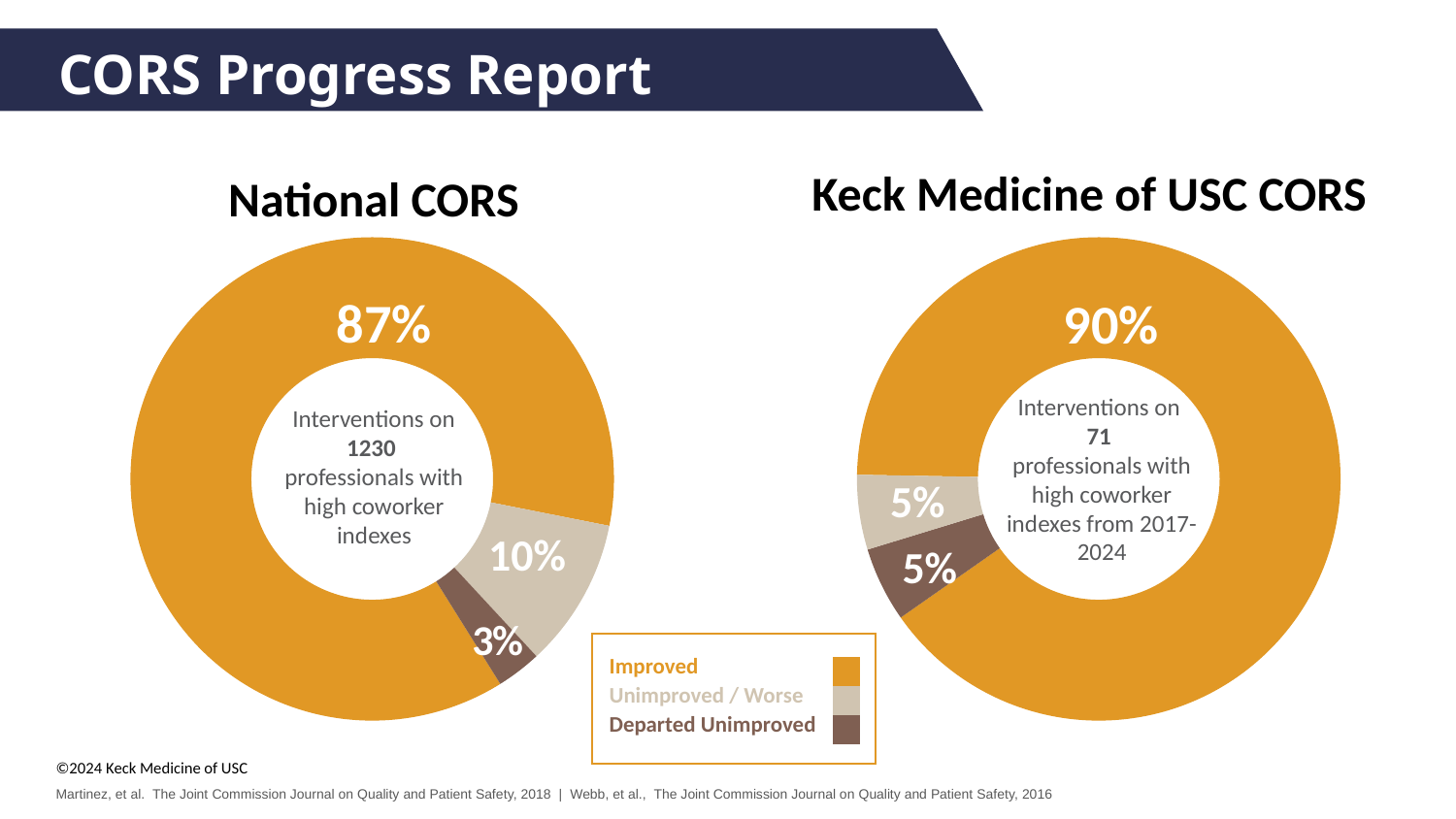
What type of chart is used for the National CORS data? Pie chart (donut) According to the National CORS chart, how many professionals with high coworker indexes received interventions? 1230 In the Keck Medicine of USC CORS chart, what percentage of interventions were Improved? 90% In the Keck Medicine of USC CORS chart, what percentage is shown for Unimproved / Worse? 5% In the National CORS chart, what percentage of interventions were Improved? 87% What is the difference between the Improved percentage in the Keck Medicine of USC CORS chart and the Improved percentage in the National CORS chart? 3% In the National CORS chart, which category has the smallest share? Departed Unimproved In the National CORS chart, which category has the largest share? Improved Which chart shows a larger Improved share, National CORS or Keck Medicine of USC CORS? Keck Medicine of USC CORS In the National CORS chart, what percentage is shown for Departed Unimproved? 3% How many categories does the legend list? 3 In the National CORS chart, what percentage is shown for Unimproved / Worse? 10%